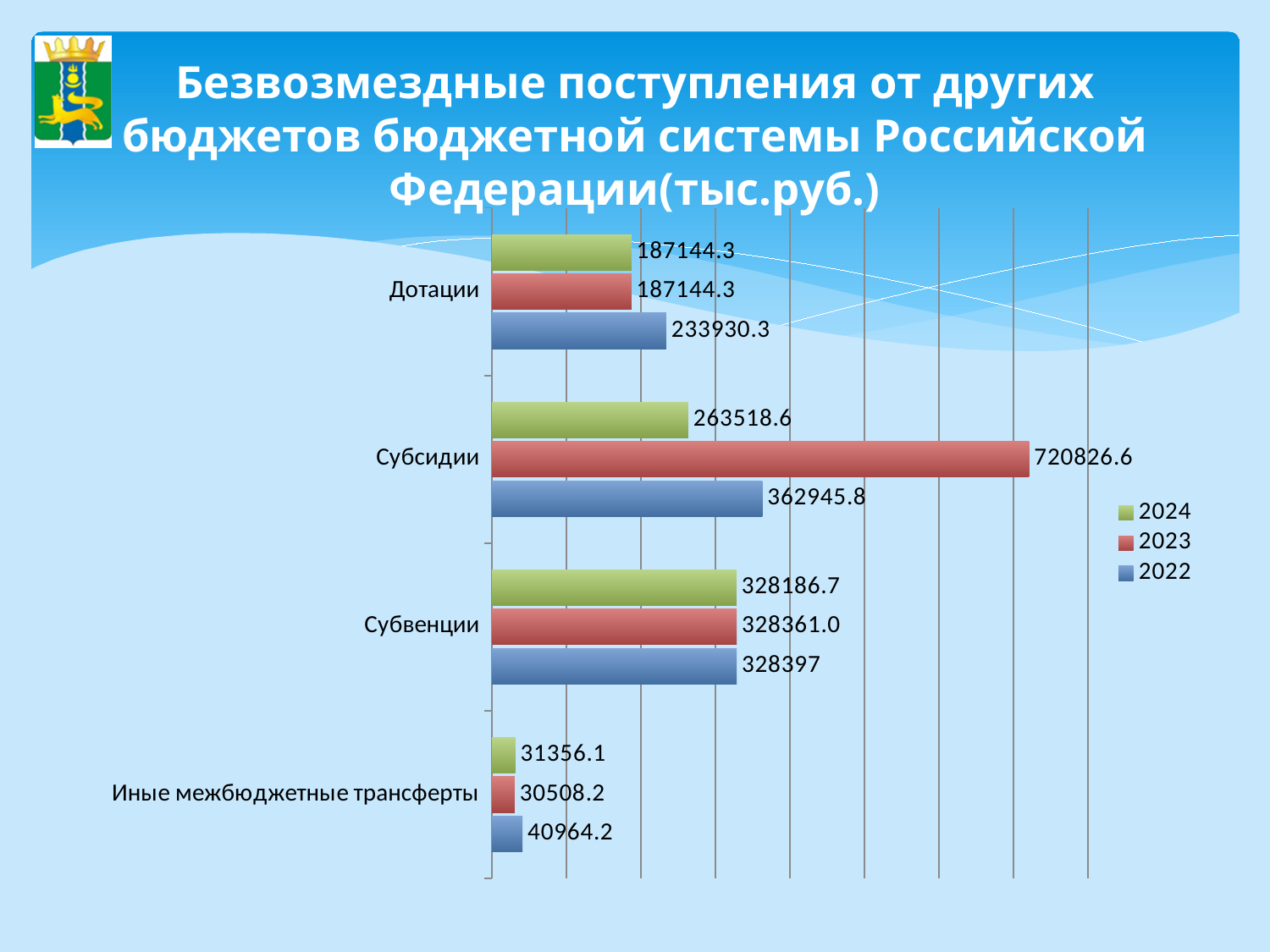
What is the value for Субвенции in the 2022 series? 328397 What is the value for Субсидии in the 2023 series? 720826.6 For Субсидии, which is larger: the 2024 value or the 2022 value? 2022 What kind of chart is shown on the slide? Bar chart How many categories are shown on the chart? 4 What is the difference between the 2022 and 2024 values for Дотации? 46786.0 What is the value for Дотации in the 2022 series? 233930.3 How many series does the legend list? 3 Which category has the lowest value in the 2022 series? Иные межбюджетные трансферты What is the value for Иные межбюджетные трансферты in the 2024 series? 31356.1 What is the difference between the 2023 and 2022 values for Субсидии? 357880.8 Which category has the highest value in the 2023 series? Субсидии